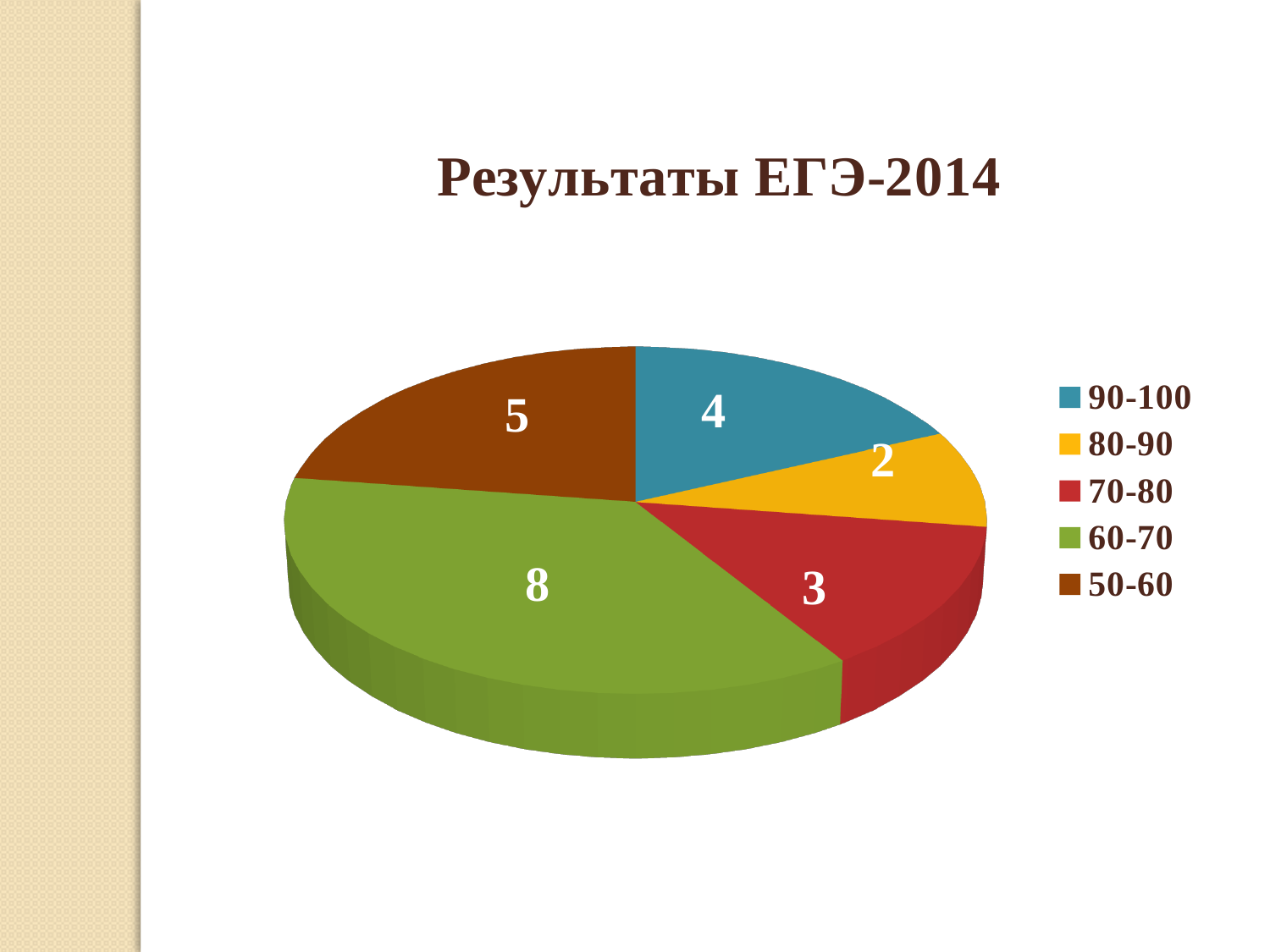
What is the value for the 50-60 slice? 5 What is the difference between the values for 60-70 and 50-60? 3 Which category has the largest slice? 60-70 What is the title of the chart? Результаты ЕГЭ-2014 How many categories does the pie chart show? 5 What is the value for the 80-90 slice? 2 Which is larger, the value for 90-100 or the value for 70-80? 90-100 What is the total of all the slice values? 22 What kind of chart is shown on the slide? Pie chart What is the value for the 60-70 slice? 8 What is the value for the 90-100 slice? 4 Which category has the smallest slice? 80-90